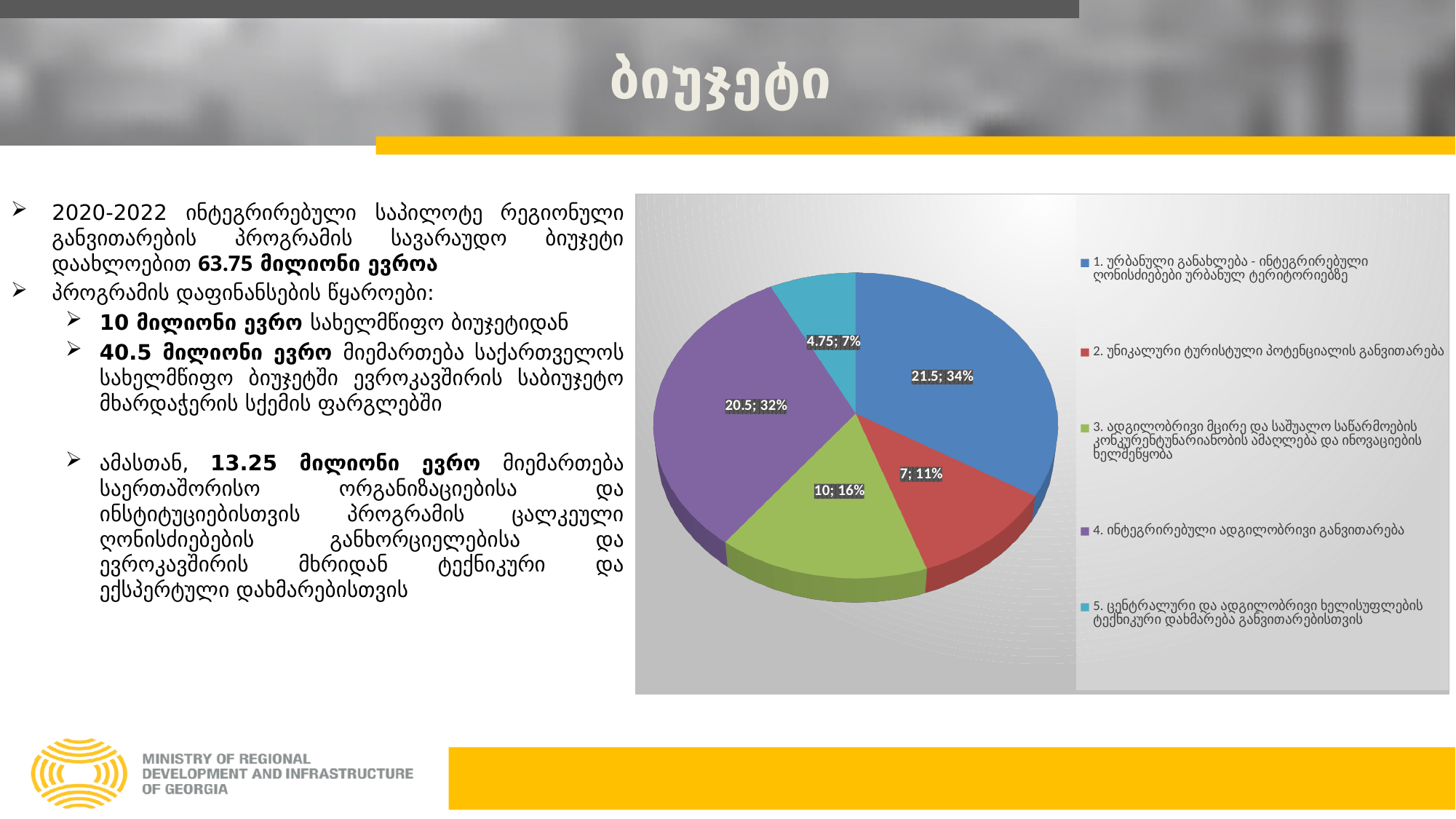
What value is printed on the blue slice (legend entry 1) of the pie chart? 21.5 Which slice has the larger value: the red slice (legend entry 2) or the green slice (legend entry 3)? the green slice (legend entry 3) How many slices does the pie chart have? 5 What is the difference between the values of the blue slice (21.5) and the purple slice (20.5)? 1 What kind of chart is shown on the slide? pie chart What percentage share is printed on the red slice (legend entry 2) of the pie chart? 11% What percentage share is printed on the purple slice (legend entry 4) of the pie chart? 32% Which legend entry corresponds to the smallest slice of the pie chart? 5 (light blue slice, 4.75; 7%) How many entries does the legend of the pie chart list? 5 What value is printed on the light blue slice (legend entry 5) of the pie chart? 4.75 What value is printed on the green slice (legend entry 3) of the pie chart? 10 Which legend entry corresponds to the largest slice of the pie chart? 1 (blue slice, 21.5; 34%)